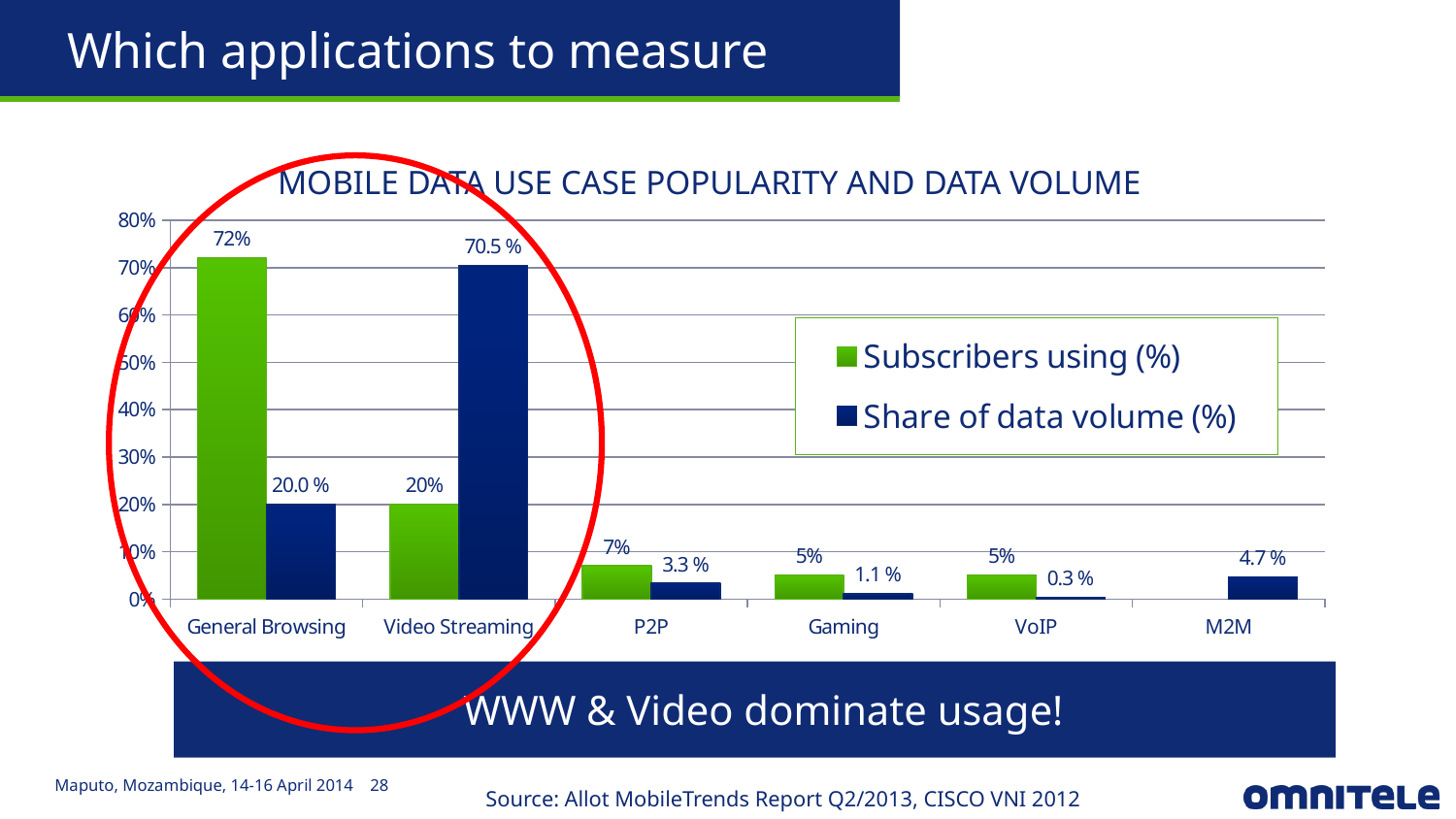
What is the Share of data volume (%) value for VoIP? 0.3 % Which is larger for P2P: Subscribers using (%) or Share of data volume (%)? Subscribers using (%) What is the title of the chart? MOBILE DATA USE CASE POPULARITY AND DATA VOLUME What is the Share of data volume (%) value for M2M? 4.7 % What is the Subscribers using (%) value for General Browsing? 72% Which category has the lowest Share of data volume (%) value? VoIP What kind of chart is shown on the slide? Bar chart Which category has the highest Subscribers using (%) value? General Browsing What is the difference between the Subscribers using (%) values for General Browsing and Video Streaming? 52% How many series does the legend list? 2 What is the Share of data volume (%) value for Video Streaming? 70.5 % How many categories are shown on the x axis? 6